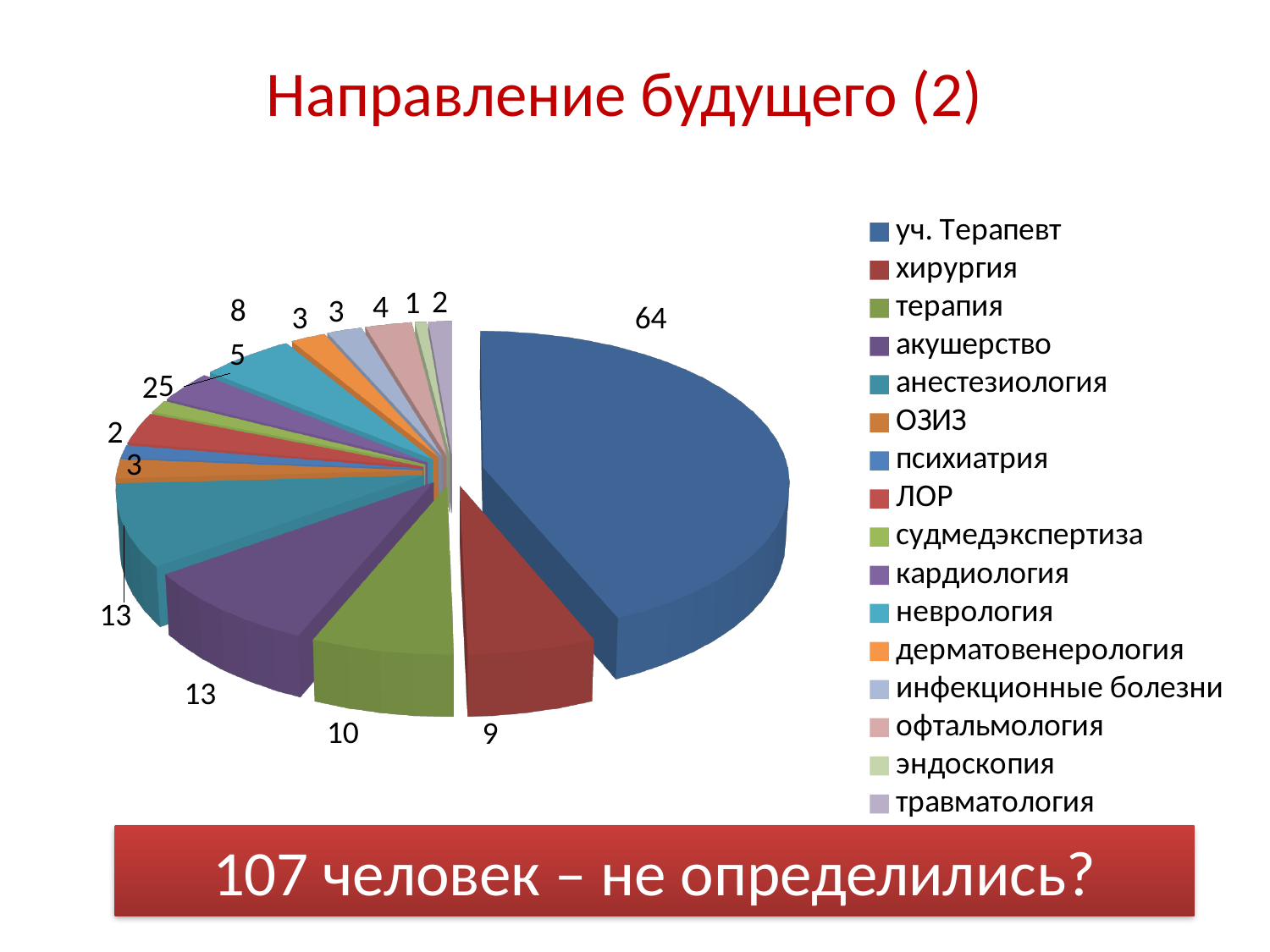
What is the value for хирургия? 9 What kind of chart is shown on the slide? pie chart What is the value for уч. Терапевт? 64 What is the value for эндоскопия? 1 What is the difference between the values for уч. Терапевт and акушерство? 51 Which category has the smallest slice? эндоскопия What is the value for акушерство? 13 Which is larger, the value for терапия or the value for хирургия? терапия Which category has the largest slice? уч. Терапевт What is the chart's title? Направление будущего (2) What is the value for терапия? 10 How many categories does the legend list? 16